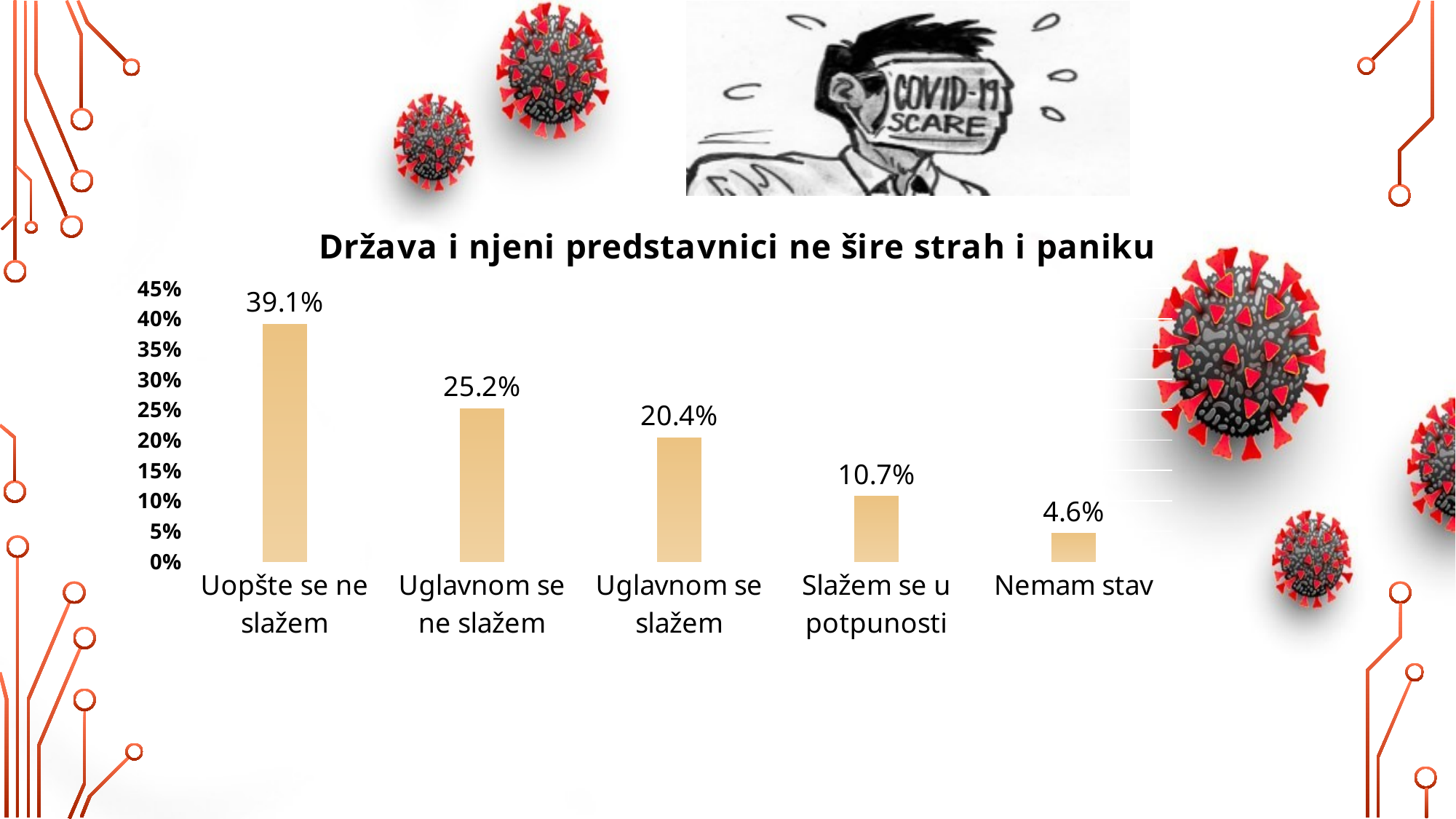
What is the value for "Uopšte se ne slažem"? 39.1% Which category has the highest value? Uopšte se ne slažem What is the value for "Nemam stav"? 4.6% How many categories are shown on the x axis? 5 What is the title of the chart? Država i njeni predstavnici ne šire strah i paniku What is the difference between the values for "Uopšte se ne slažem" and "Uglavnom se ne slažem"? 13.9% What is the value for "Slažem se u potpunosti"? 10.7% Which is larger, the value for "Uglavnom se slažem" or the value for "Slažem se u potpunosti"? Uglavnom se slažem What kind of chart is shown on the slide? Bar chart Which category has the lowest value? Nemam stav What is the value for "Uglavnom se ne slažem"? 25.2% What is the value for "Uglavnom se slažem"? 20.4%